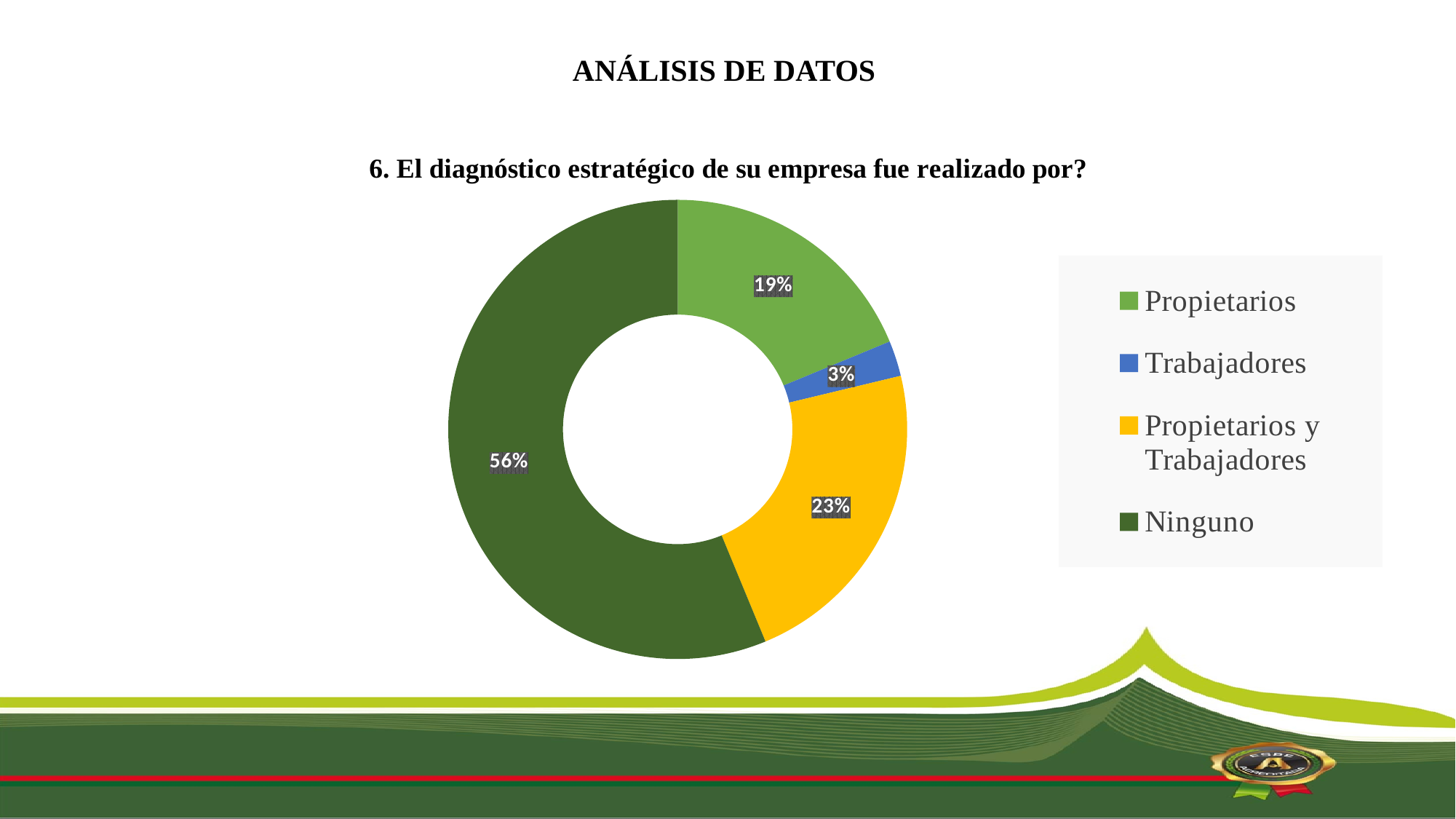
What colour is the Trabajadores slice? Blue Which category has the largest share? Ninguno How many categories does the chart show? 4 What is the value shown for Propietarios? 19% What is the value shown for Trabajadores? 3% What is the title of the chart? 6. El diagnóstico estratégico de su empresa fue realizado por? Which is larger, the share for Propietarios or the share for Propietarios y Trabajadores? Propietarios y Trabajadores What share of the pie does Ninguno represent? 56% What is the difference between the shares for Ninguno and Propietarios y Trabajadores? 33% What kind of chart is shown on the slide? Pie chart (doughnut) Which category has the smallest share? Trabajadores What is the value shown for Propietarios y Trabajadores? 23%